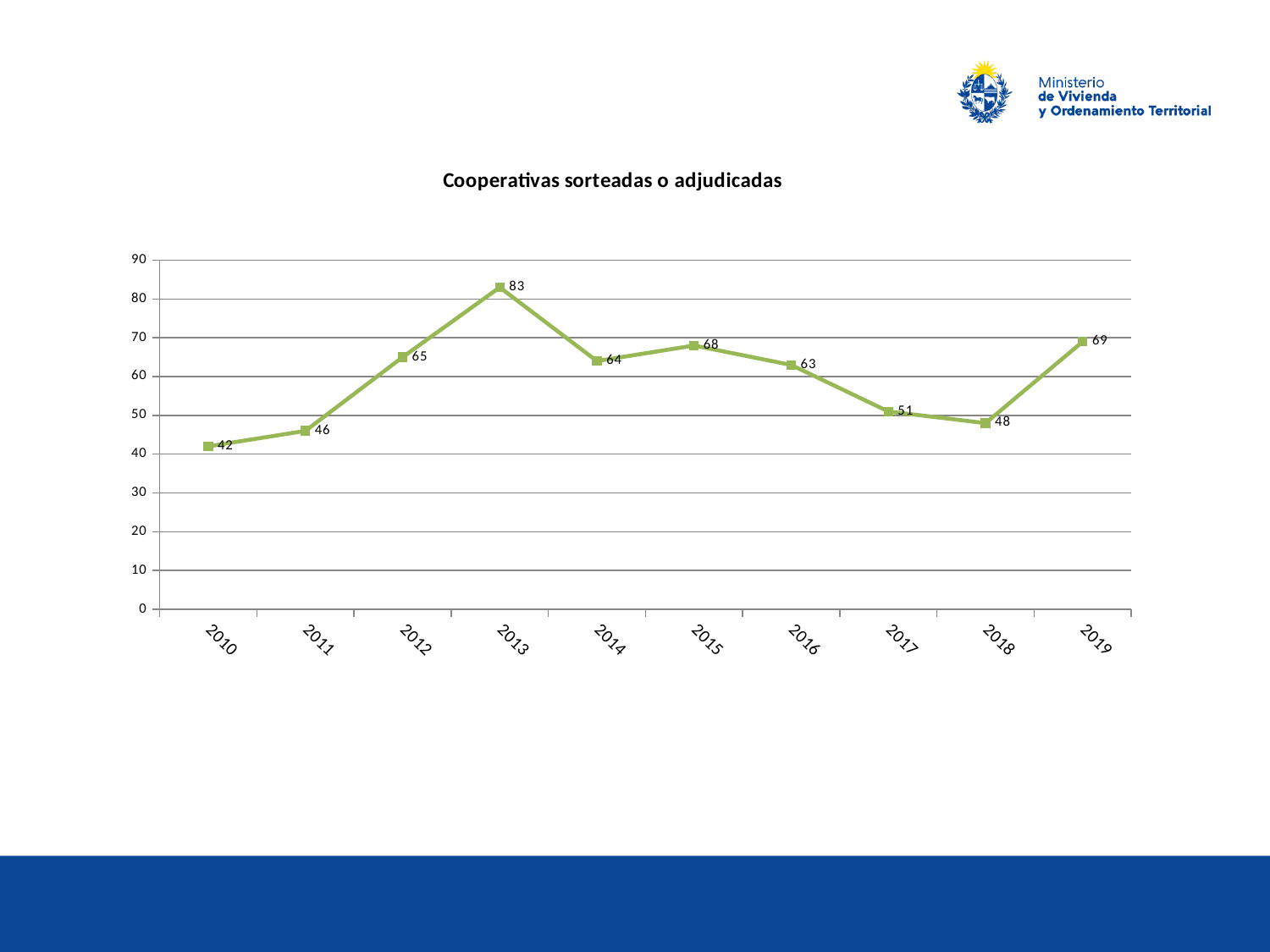
What is the value for 2019? 69 What is the value for 2013? 83 How many years are plotted on the chart? 10 Which year has the lowest value? 2010 Do the values rise or fall from 2010 to 2013? rise Which is larger, the value for 2012 or the value for 2015? 2015 Is the value for 2017 greater or less than 60? less What kind of chart is shown? line chart What is the difference between the values for 2013 and 2014? 19 What is the title of the chart? Cooperativas sorteadas o adjudicadas What is the value for 2010? 42 Which year has the highest value? 2013